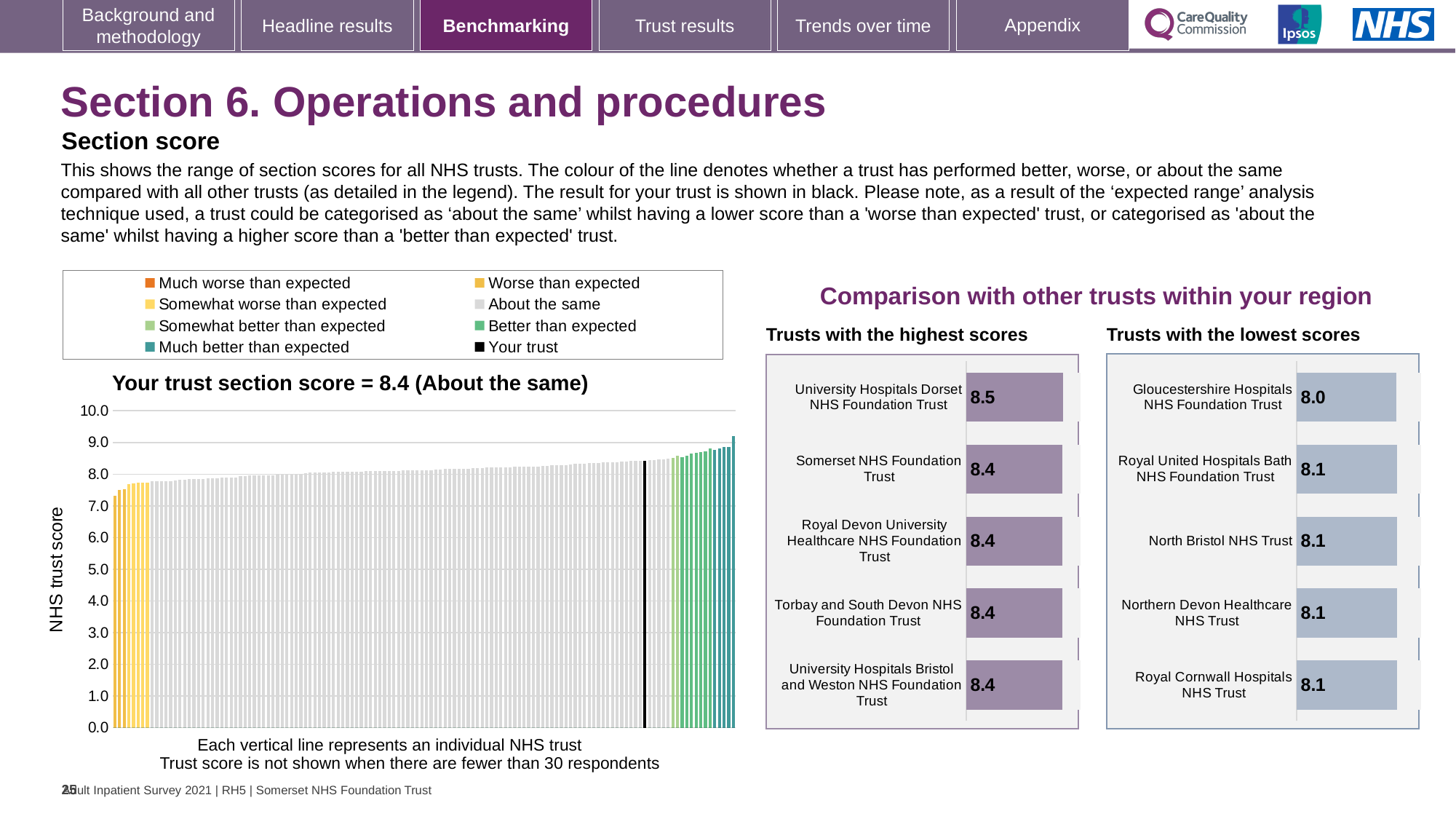
In the chart 'Trusts with the lowest scores', what is the difference between the score for Royal Cornwall Hospitals NHS Trust and the score for Gloucestershire Hospitals NHS Foundation Trust? 0.1 In the chart titled 'Your trust section score', what is the section score for your trust? 8.4 In the chart 'Trusts with the lowest scores', what is the score for Gloucestershire Hospitals NHS Foundation Trust? 8.0 In the chart titled 'Your trust section score', is the value of the lowest (leftmost) bar greater or less than 8.0? less In the chart titled 'Your trust section score', do the bar heights rise or fall from left to right along the x axis? rise In the chart 'Trusts with the lowest scores', which trust has the lowest score? Gloucestershire Hospitals NHS Foundation Trust In the chart 'Trusts with the highest scores', what is the score for University Hospitals Dorset NHS Foundation Trust? 8.5 How many entries does the legend above the 'Your trust section score' chart list? 8 What kind of chart is the chart titled 'Your trust section score = 8.4 (About the same)'? bar chart In the chart 'Trusts with the highest scores', which trust has the highest score? University Hospitals Dorset NHS Foundation Trust How many trusts are shown in the chart 'Trusts with the highest scores'? 5 What is the y-axis label of the chart titled 'Your trust section score'? NHS trust score